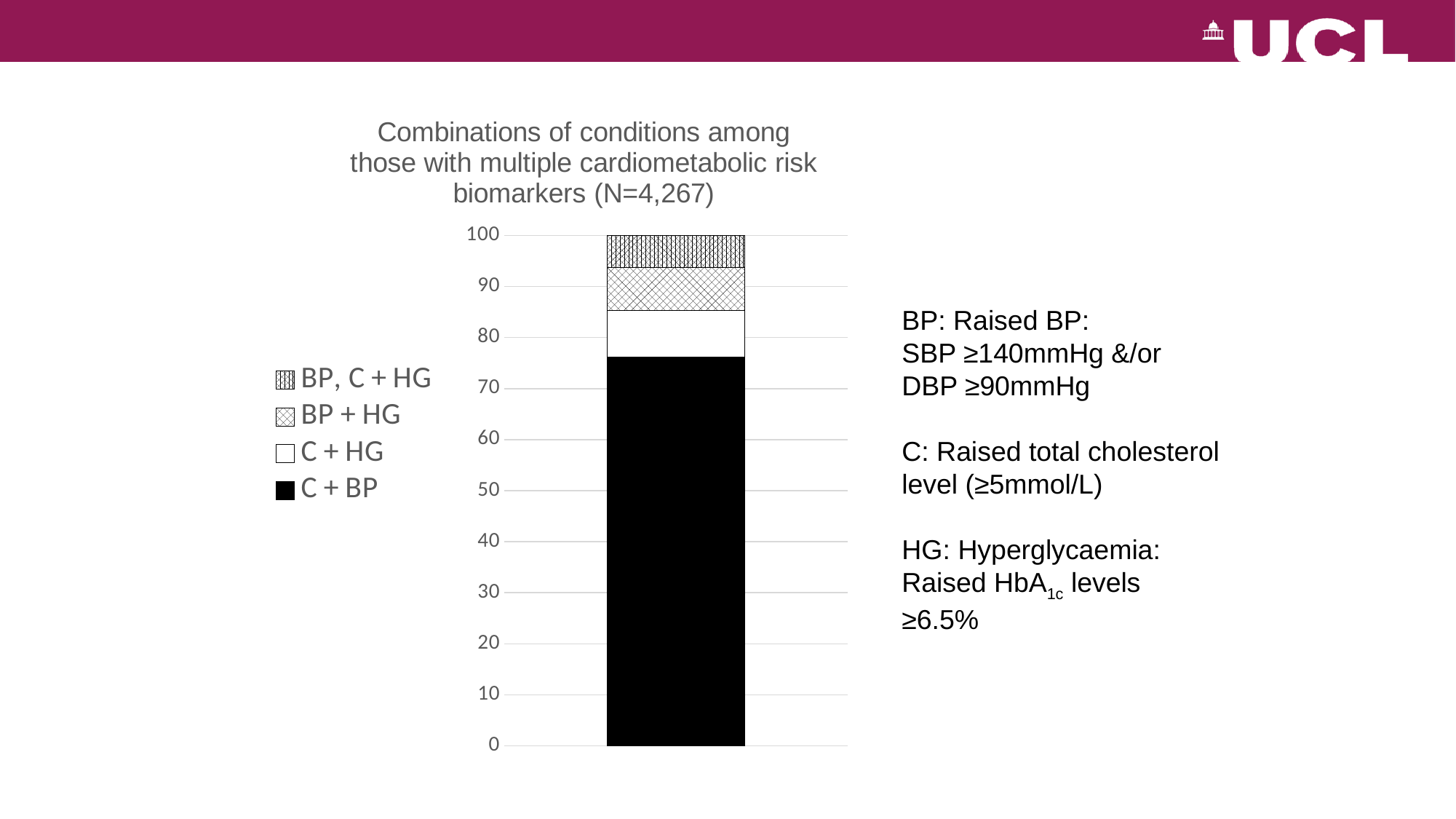
Which is larger, the C + BP segment or the BP + HG segment? C + BP How many series does the legend list? 4 What is the total height of the stacked bar? 100 Is the value for the C + BP segment greater or less than 70? greater What kind of chart is shown on the slide? Stacked bar chart What is the sample size (N) given in the chart title? 4,267 Is the value for the C + HG segment greater or less than 20? less How many bars are plotted in the chart? 1 Which legend entry is shown with a solid black fill? C + BP Is the value for the C + BP segment greater or less than 80? less Which segment of the stacked bar is the largest? C + BP